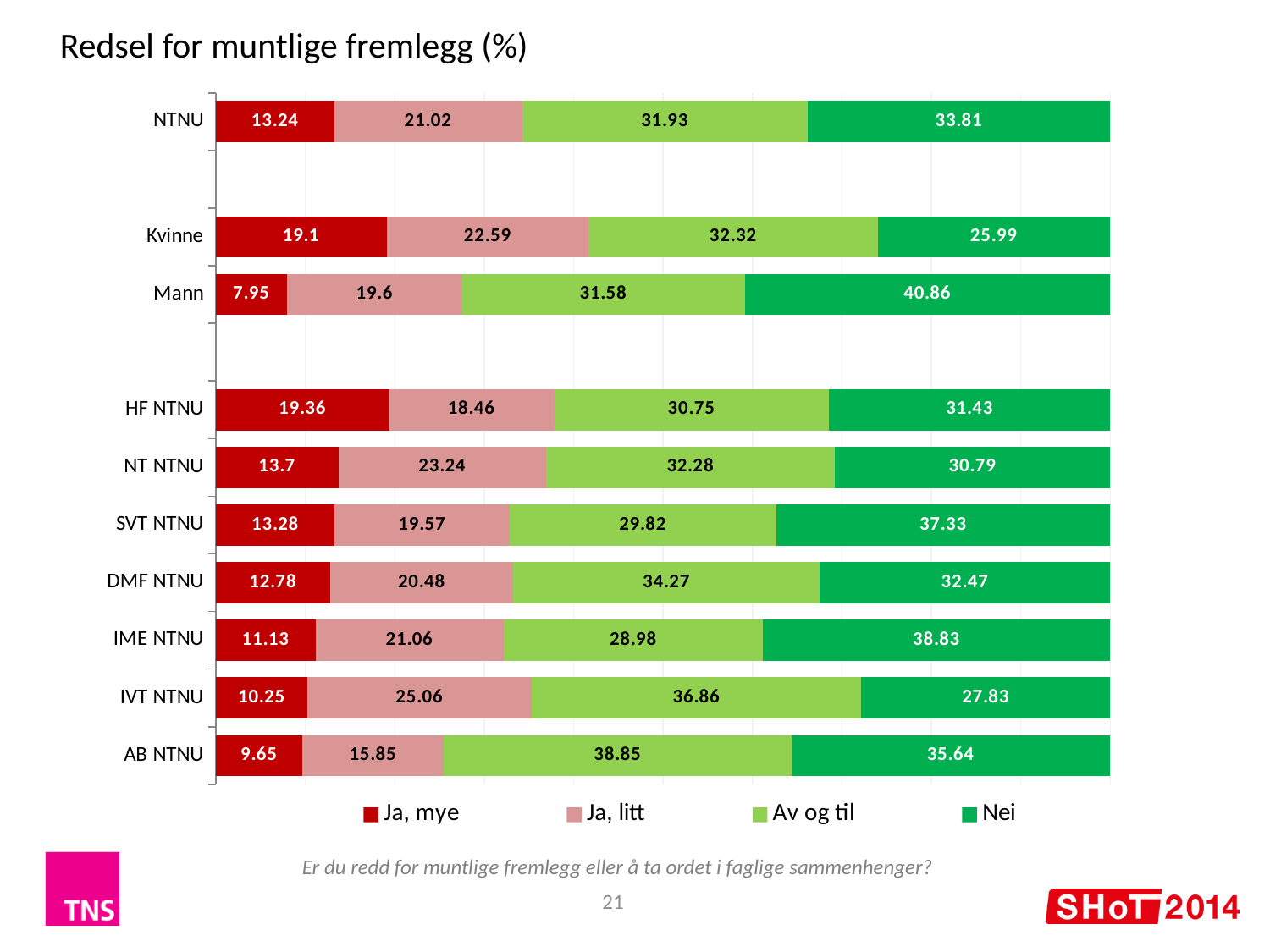
Which category has the lowest value for "Ja, mye"? Mann Which category has the lowest value for "Ja, litt"? AB NTNU How many series does the legend list? 4 Which has the larger "Av og til" value, IVT NTNU or AB NTNU? AB NTNU What is the value of "Ja, mye" for Kvinne? 19.1 What is the difference between the "Nei" values for Mann and Kvinne? 14.87 What is the value of "Av og til" for AB NTNU? 38.85 What is the value of "Nei" for Mann? 40.86 How many categories are shown on the chart? 10 What is the title of the chart? Redsel for muntlige fremlegg (%) Which category has the highest value for "Nei"? Mann What kind of chart is shown on the slide? Stacked bar chart